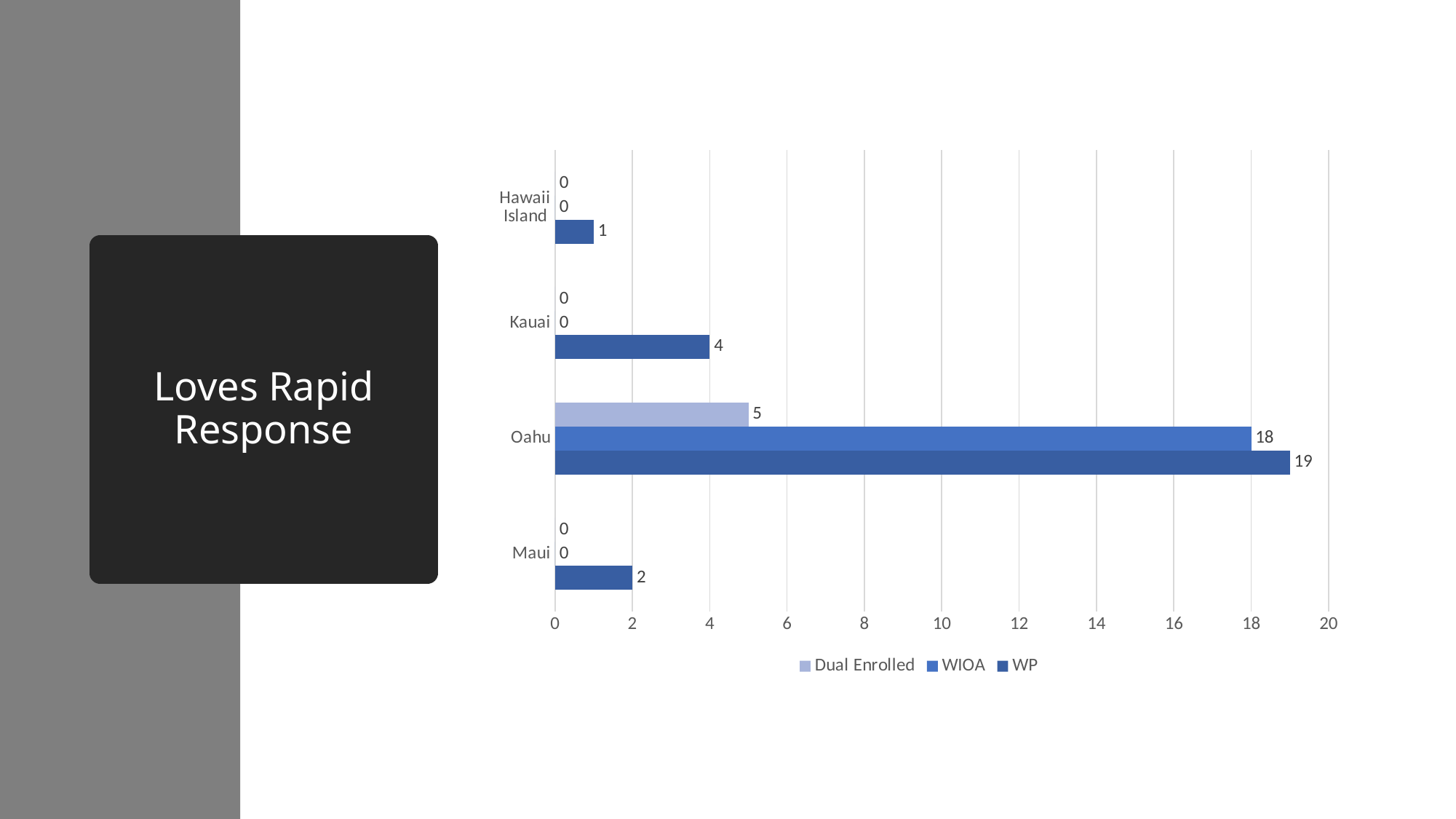
How many series does the legend list? 3 Which is larger for Oahu, the WIOA value or the Dual Enrolled value? WIOA What is the Dual Enrolled value for Oahu? 5 Which category has the lowest WP value? Hawaii Island What is the WP value for Kauai? 4 How many categories are shown on the chart? 4 What is the difference between the WP values for Oahu and Kauai? 15 Which category has the highest WP value? Oahu What is the WP value for Maui? 2 What is the WP value for Oahu? 19 What is the WIOA value for Oahu? 18 What kind of chart is shown on the slide? Bar chart